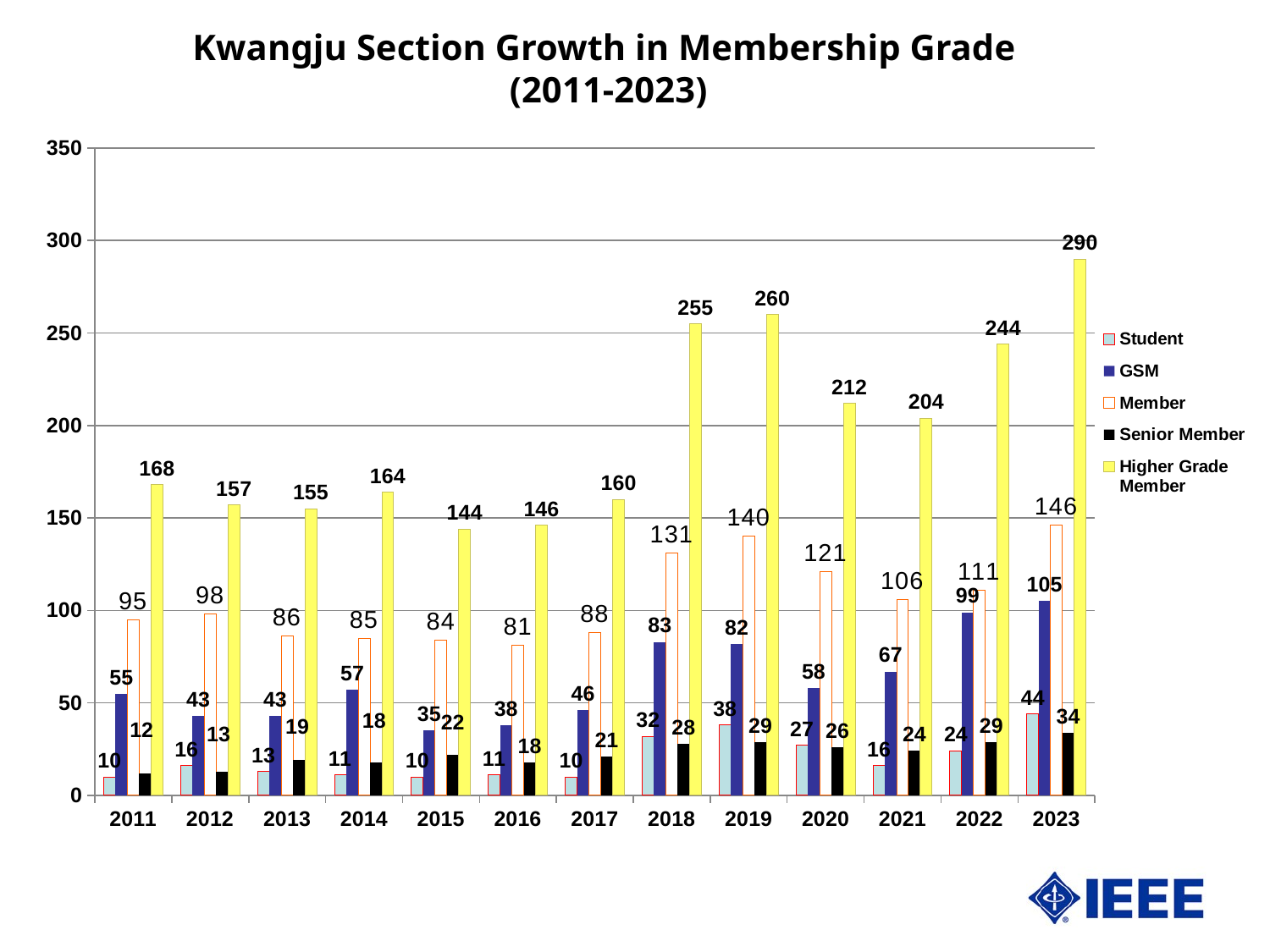
Which series is shown in yellow? Higher Grade Member What is the value for Senior Member in 2015? 22 What is the value for Higher Grade Member in 2023? 290 What kind of chart is shown on the slide? Bar chart What is the value for Member in 2019? 140 How many years are shown on the x axis? 13 In which year is the Higher Grade Member value the lowest? 2015 What is the value for GSM in 2018? 83 Which is larger, the Student value in 2019 or the Student value in 2020? 2019 How many series does the legend list? 5 In which year is the Higher Grade Member value the highest? 2023 What is the difference between the Higher Grade Member values in 2023 and 2022? 46